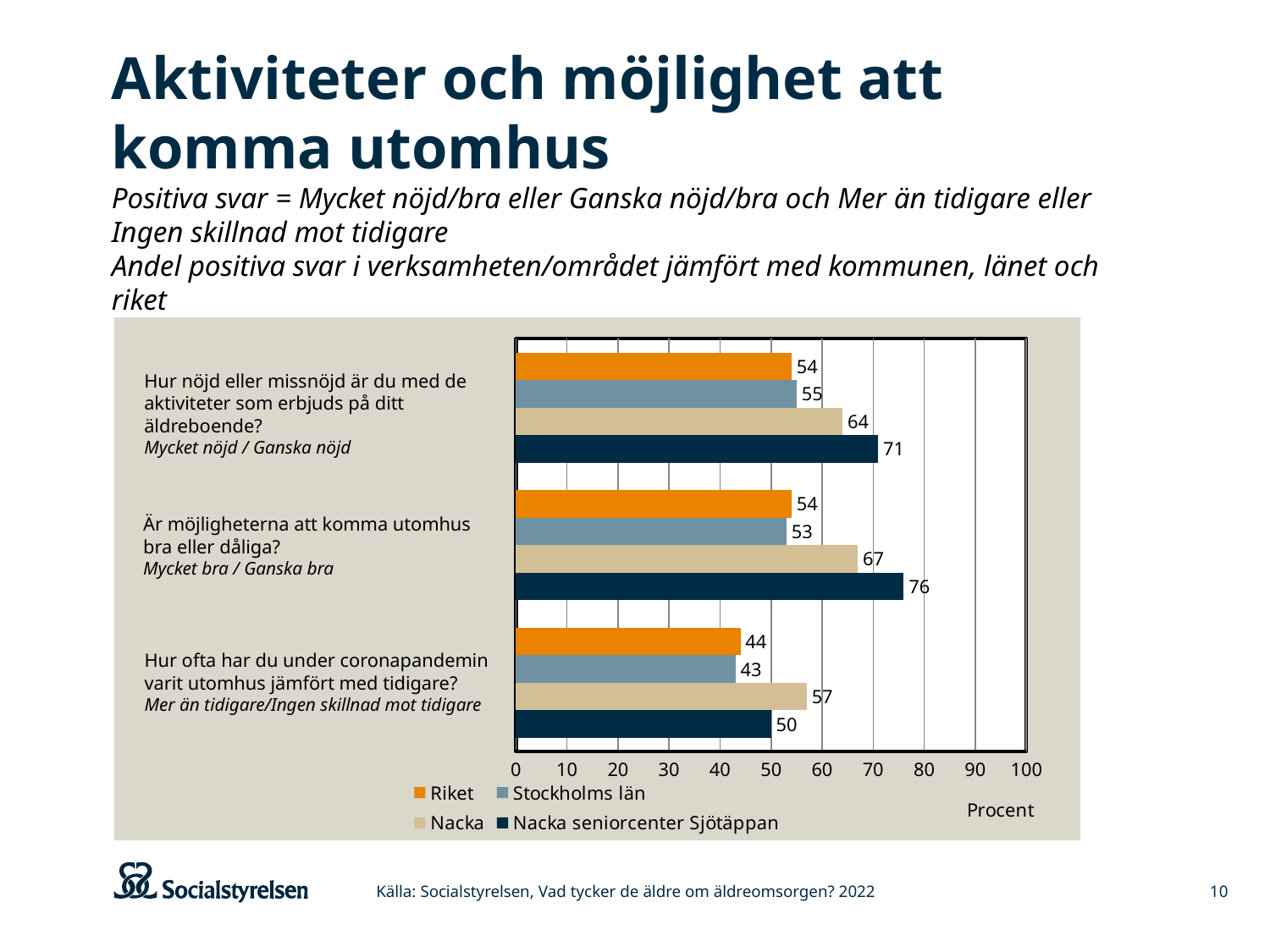
What is the unit label shown below the x axis of the chart? Procent How many question categories are shown on the chart? 3 How many series does the legend list? 4 What is the value for Nacka on the question "Hur nöjd eller missnöjd är du med de aktiviteter som erbjuds på ditt äldreboende?"? 64 On the question "Hur ofta har du under coronapandemin varit utomhus jämfört med tidigare?", which is larger: Nacka or Nacka seniorcenter Sjötäppan? Nacka What is the value for Nacka seniorcenter Sjötäppan on the question "Är möjligheterna att komma utomhus bra eller dåliga?"? 76 Which series has the highest value on the question "Hur ofta har du under coronapandemin varit utomhus jämfört med tidigare?"? Nacka Is the value for Nacka seniorcenter Sjötäppan on the question "Är möjligheterna att komma utomhus bra eller dåliga?" greater or less than 70? greater What is the difference between Nacka seniorcenter Sjötäppan and Riket on the question "Hur nöjd eller missnöjd är du med de aktiviteter som erbjuds på ditt äldreboende?"? 17 What kind of chart is shown on the slide? Bar chart What is the value for Riket on the question "Hur ofta har du under coronapandemin varit utomhus jämfört med tidigare?"? 44 Which series has the lowest value on the question "Är möjligheterna att komma utomhus bra eller dåliga?"? Stockholms län